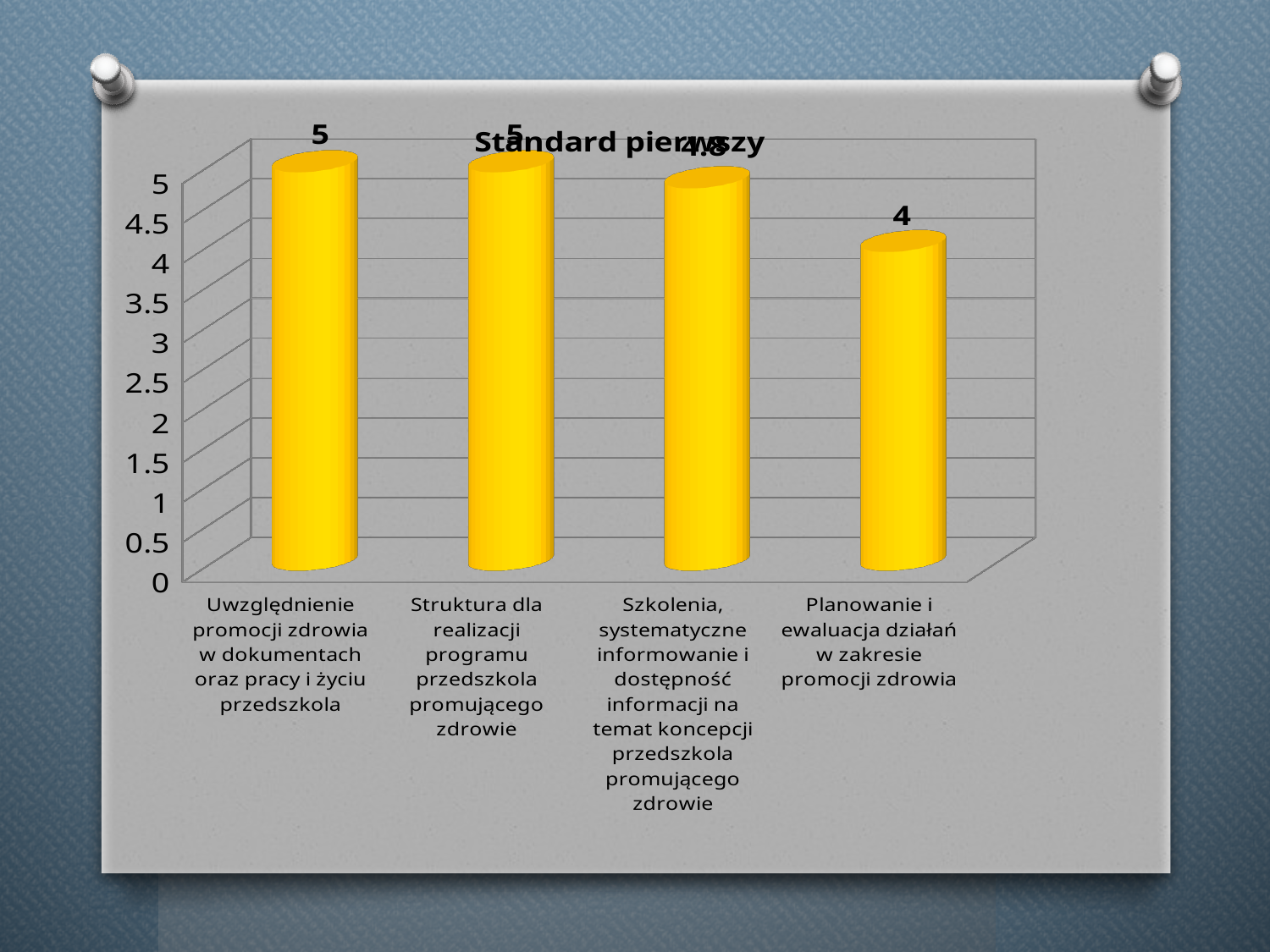
What is the value for "Struktura dla realizacji programu przedszkola promującego zdrowie"? 5 What kind of chart is shown on the slide? Bar chart What is the difference between the value for "Uwzględnienie promocji zdrowia w dokumentach oraz pracy i życiu przedszkola" and the value for "Planowanie i ewaluacja działań w zakresie promocji zdrowia"? 1 What is the value for "Uwzględnienie promocji zdrowia w dokumentach oraz pracy i życiu przedszkola"? 5 What is the difference between the value for "Szkolenia, systematyczne informowanie i dostępność informacji na temat koncepcji przedszkola promującego zdrowie" and the value for "Planowanie i ewaluacja działań w zakresie promocji zdrowia"? 0.8 Which is larger: the value for "Struktura dla realizacji programu przedszkola promującego zdrowie" or the value for "Planowanie i ewaluacja działań w zakresie promocji zdrowia"? Struktura dla realizacji programu przedszkola promującego zdrowie How many categories are shown in the chart? 4 Do the values rise or fall from left to right across the categories? Fall What is the title of the chart? Standard pierwszy What is the value for "Szkolenia, systematyczne informowanie i dostępność informacji na temat koncepcji przedszkola promującego zdrowie"? 4.8 Which category has the lowest value? Planowanie i ewaluacja działań w zakresie promocji zdrowia What is the value for "Planowanie i ewaluacja działań w zakresie promocji zdrowia"? 4